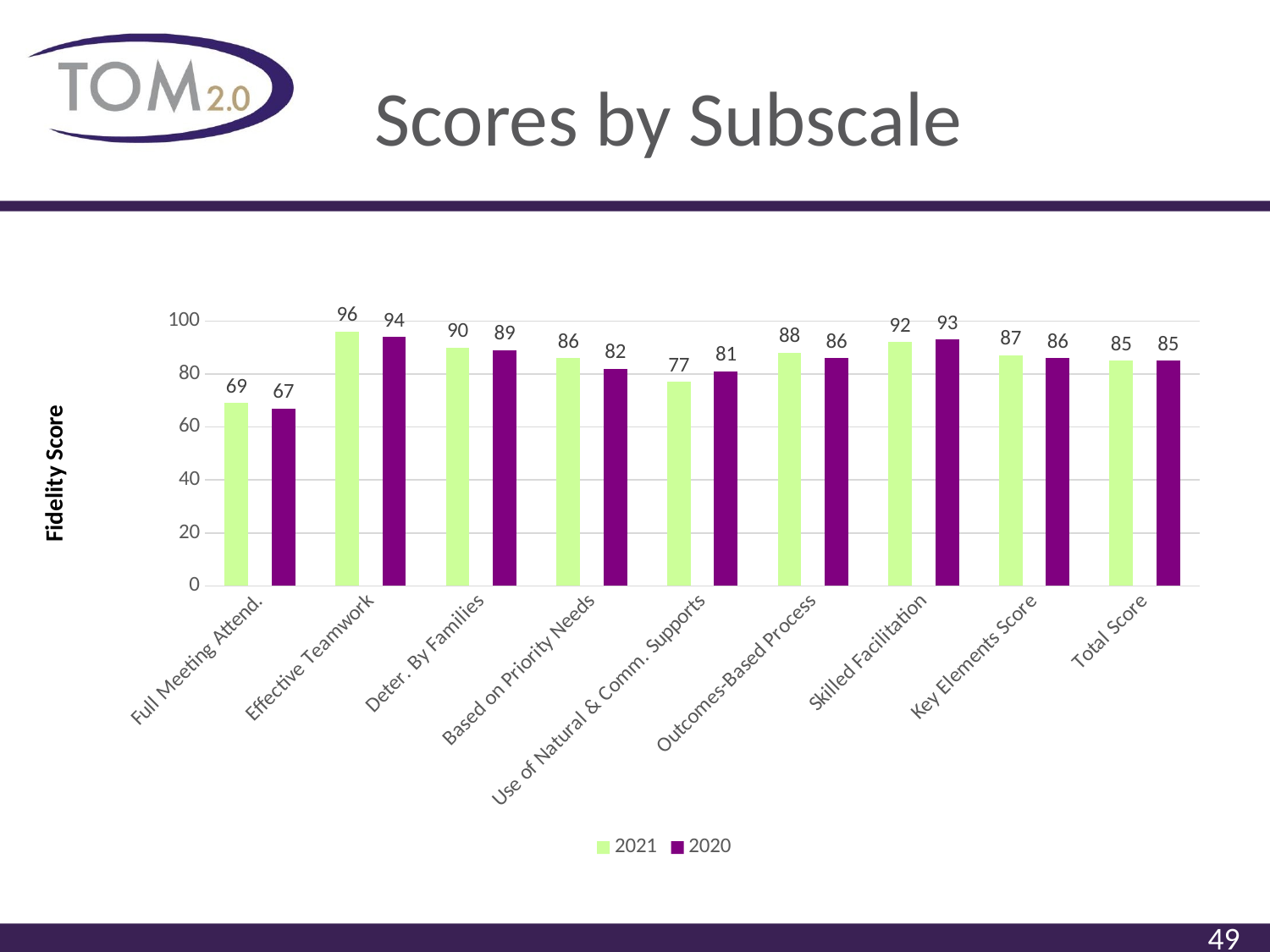
What kind of chart is shown on the slide? Bar chart What is the 2020 Fidelity Score for Use of Natural & Comm. Supports? 81 For Skilled Facilitation, which year has the higher score, 2021 or 2020? 2020 What is the 2021 Fidelity Score for Effective Teamwork? 96 What is the Total Score for 2020? 85 Which subscale has the highest 2021 score? Effective Teamwork What is the 2021 Fidelity Score for Full Meeting Attend.? 69 What is the label of the vertical axis? Fidelity Score How many subscale categories are shown on the x axis? 9 Which subscale has the lowest 2020 score? Full Meeting Attend. What is the difference between the 2021 and 2020 scores for Based on Priority Needs? 4 How many series does the legend list? 2